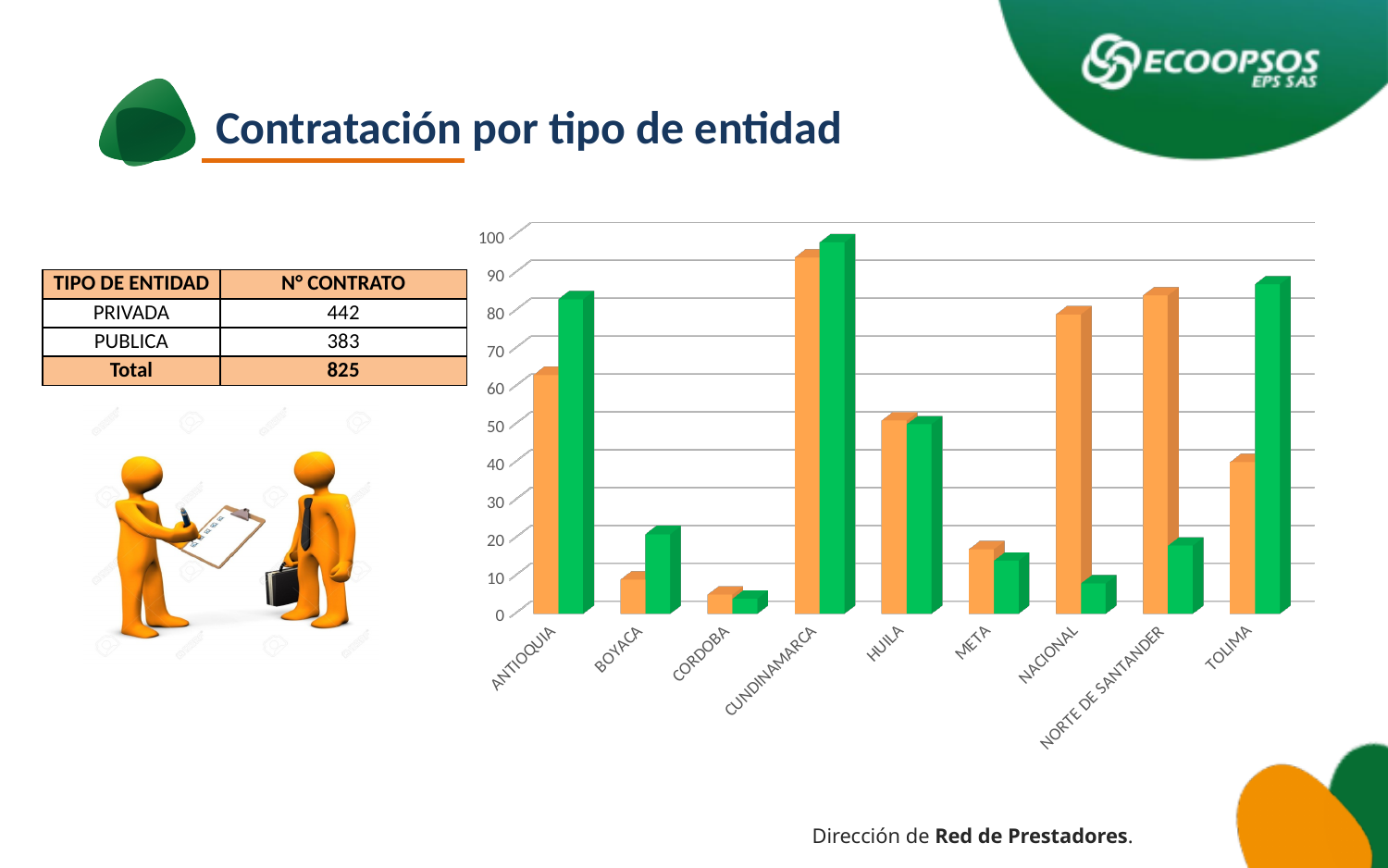
Is the green bar for NACIONAL greater or less than 20? less For NACIONAL, which bar is taller, the orange one or the green one? orange How many categories are shown along the x axis of the chart? 9 What two colours are used for the bars in the chart? orange and green Which category has the tallest green bar in the chart? CUNDINAMARCA Is the orange bar for BOYACA greater or less than 20? less Is the orange bar for CUNDINAMARCA greater or less than 90? greater Which category has the shortest orange bar in the chart? CORDOBA What kind of chart is shown on the slide? bar chart For TOLIMA, which bar is taller, the orange one or the green one? green Which category has the tallest orange bar in the chart? CUNDINAMARCA